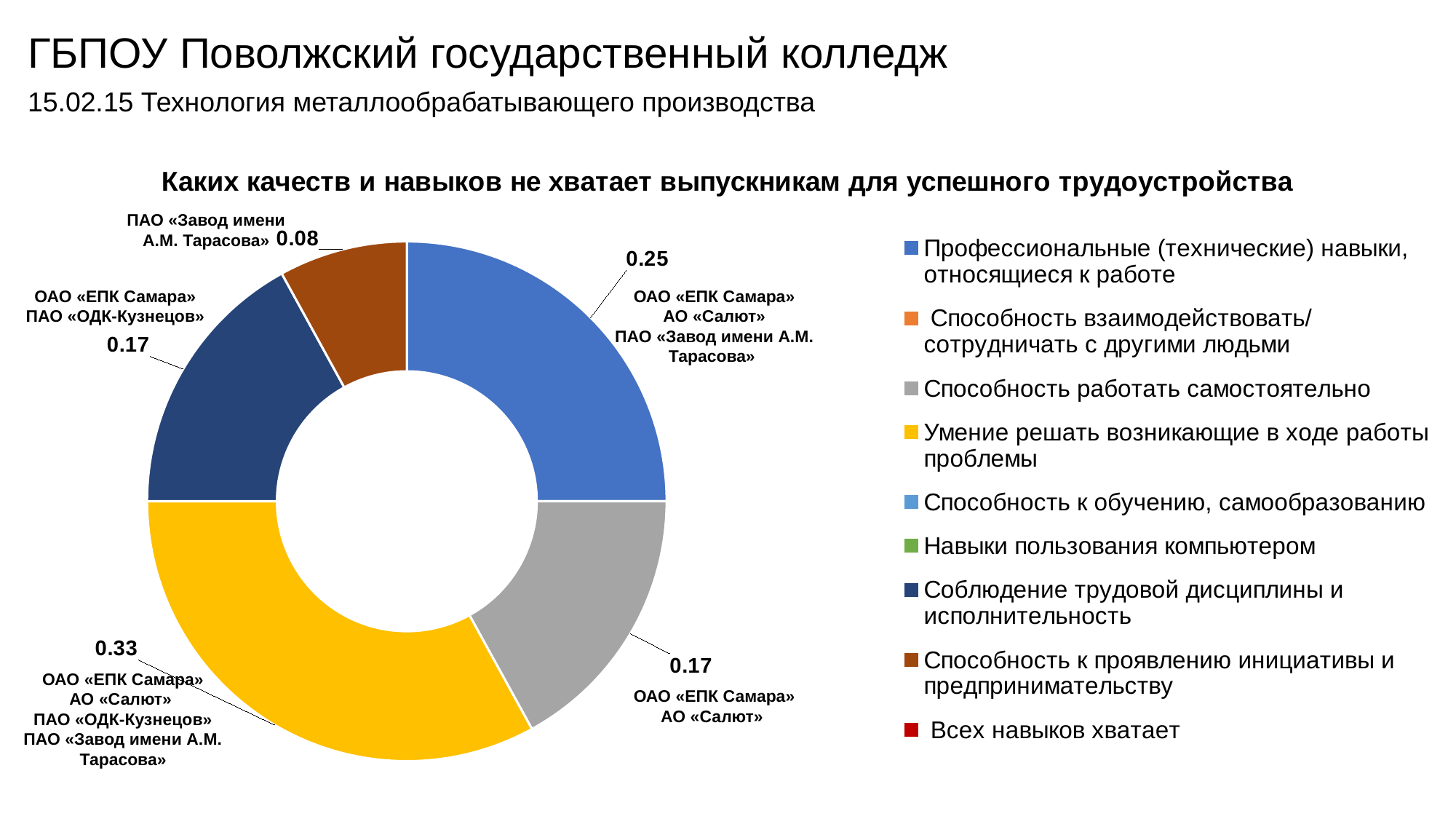
Which category with a visible slice has the smallest value? Способность к проявлению инициативы и предпринимательству What colour is the slice for «Способность работать самостоятельно»? Grey What is the value for «Умение решать возникающие в ходе работы проблемы»? 0.33 What is the title of the chart? Каких качеств и навыков не хватает выпускникам для успешного трудоустройства Which is larger: the value for «Профессиональные (технические) навыки, относящиеся к работе» or for «Способность работать самостоятельно»? Профессиональные (технические) навыки, относящиеся к работе Which category has the largest slice in the chart? Умение решать возникающие в ходе работы проблемы What is the value for «Профессиональные (технические) навыки, относящиеся к работе»? 0.25 How many entries does the chart legend list? 9 What kind of chart is shown on the slide? Doughnut chart What is the value for «Способность к проявлению инициативы и предпринимательству»? 0.08 What is the difference between the values for «Умение решать возникающие в ходе работы проблемы» and «Профессиональные (технические) навыки, относящиеся к работе»? 0.08 What is the value for «Соблюдение трудовой дисциплины и исполнительность»? 0.17